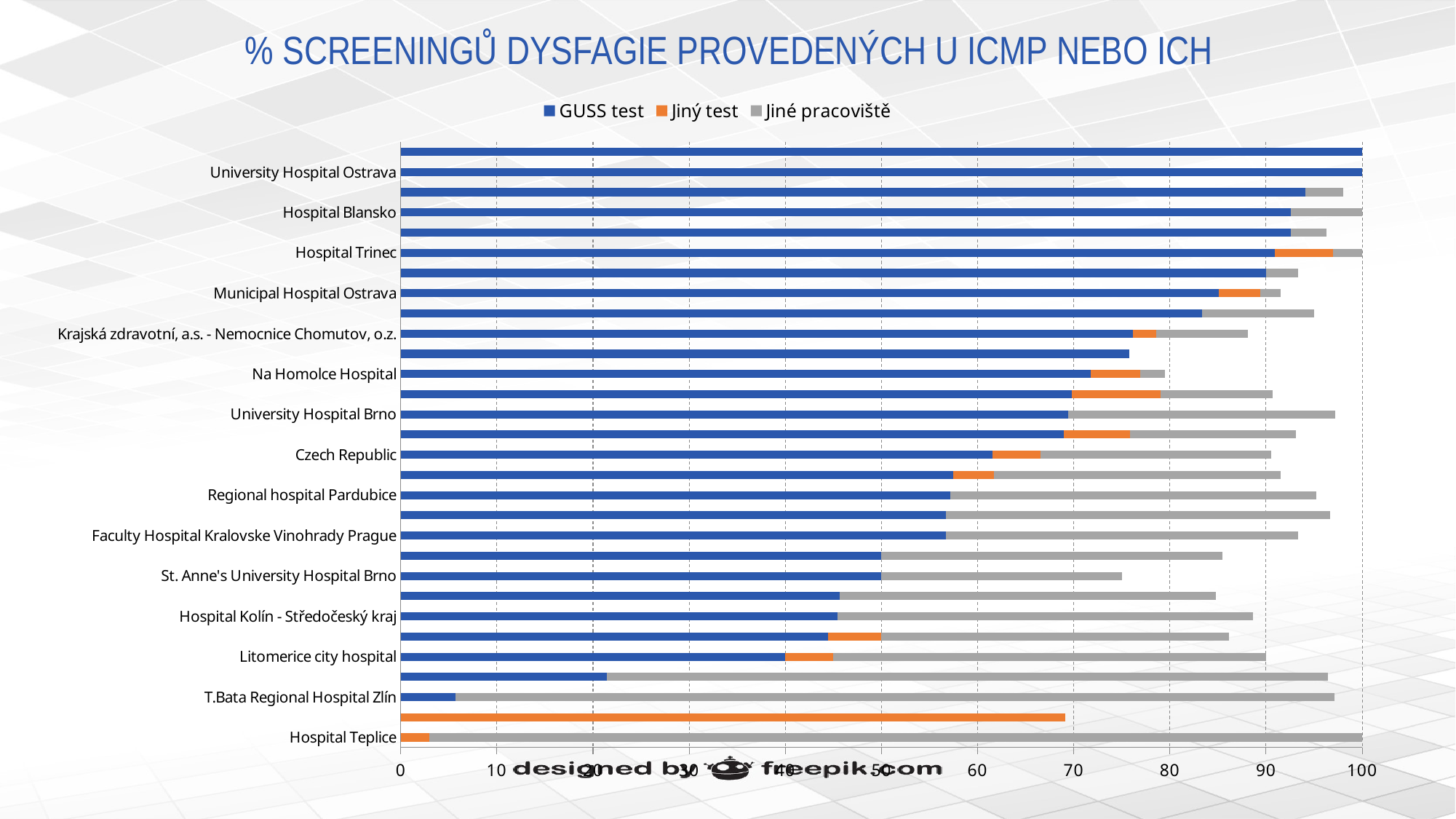
How many series does the legend list? 3 Which has the larger GUSS test value, Czech Republic or St. Anne's University Hospital Brno? Czech Republic Which colour represents the 'Jiný test' series? orange Is the GUSS test value for University Hospital Ostrava greater or less than 90? greater Which has the larger GUSS test value, Na Homolce Hospital or Litomerice city hospital? Na Homolce Hospital Is the GUSS test value for Czech Republic greater or less than 60? greater What kind of chart is shown on the slide? bar chart Is the GUSS test value for Hospital Blansko greater or less than 90? greater Among the labelled hospitals, which has the highest GUSS test value? University Hospital Ostrava What are the three series named in the legend? GUSS test, Jiný test, Jiné pracoviště